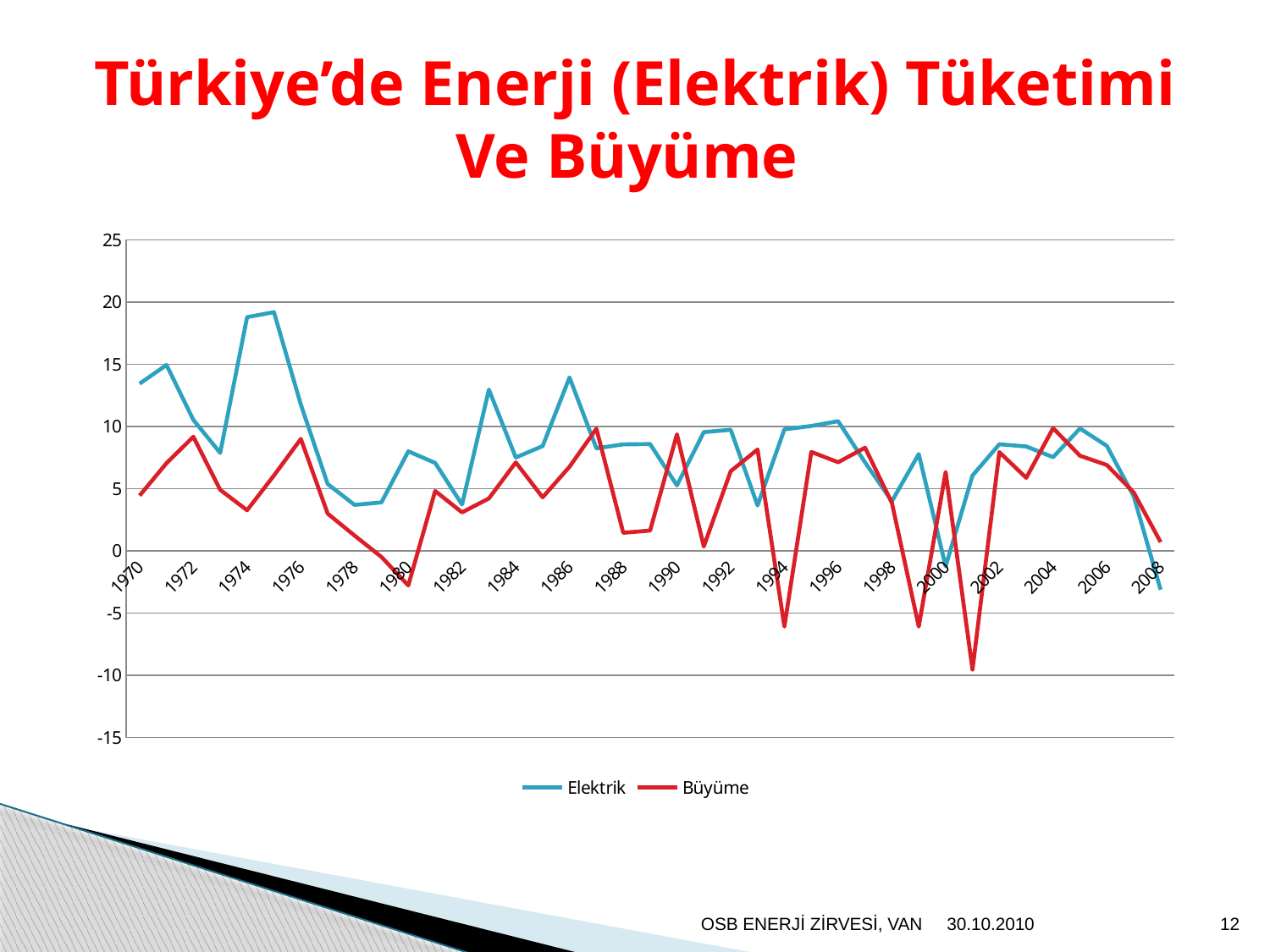
What are the two series named in the legend? Elektrik and Büyüme Is the Büyüme value for 1980 greater or less than 0? less How many series does the legend list? 2 Is the Elektrik value for 2008 greater or less than 0? less Is the Büyüme value for 2001 greater or less than -5? less In 1975, which series has the larger value, Elektrik or Büyüme? Elektrik Does the Elektrik series rise or fall between 2005 and 2008? fall What kind of chart is shown on the slide? line chart In which year does the Büyüme series reach its lowest value? 2001 Which colour is used for the Büyüme series? red